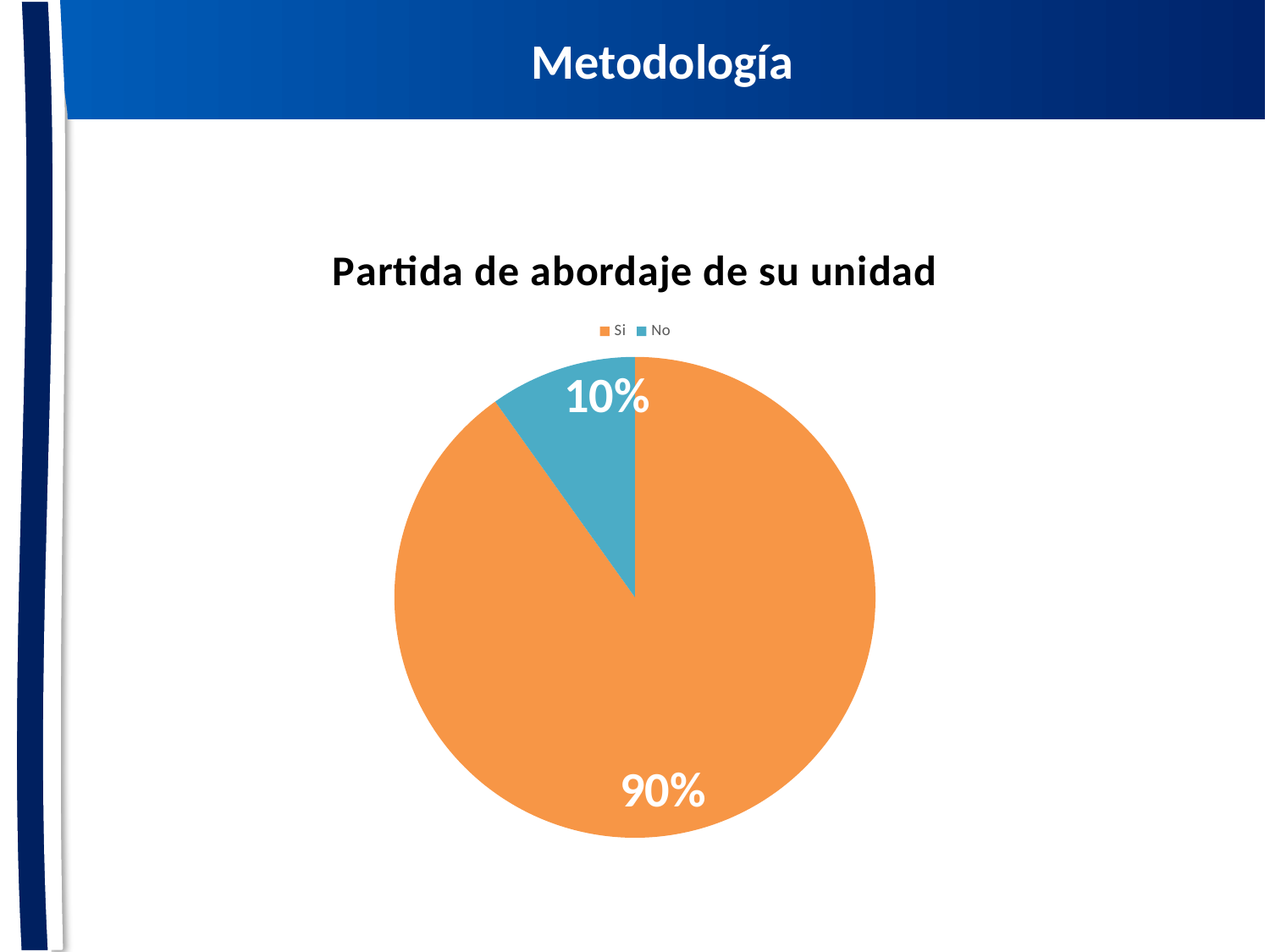
What is the title of the chart? Partida de abordaje de su unidad Which slice is larger, "Si" or "No"? Si What colour is the "No" slice? blue Which category has the largest slice of the pie? Si What share of the pie does the "No" slice represent? 10% Which category has the smallest slice of the pie? No What kind of chart is shown on the slide? pie chart What share of the pie does the "Si" slice represent? 90% How many slices does the pie chart have? 2 What is the difference in percentage points between the "Si" and "No" slices? 80 percentage points How many entries does the legend list? 2